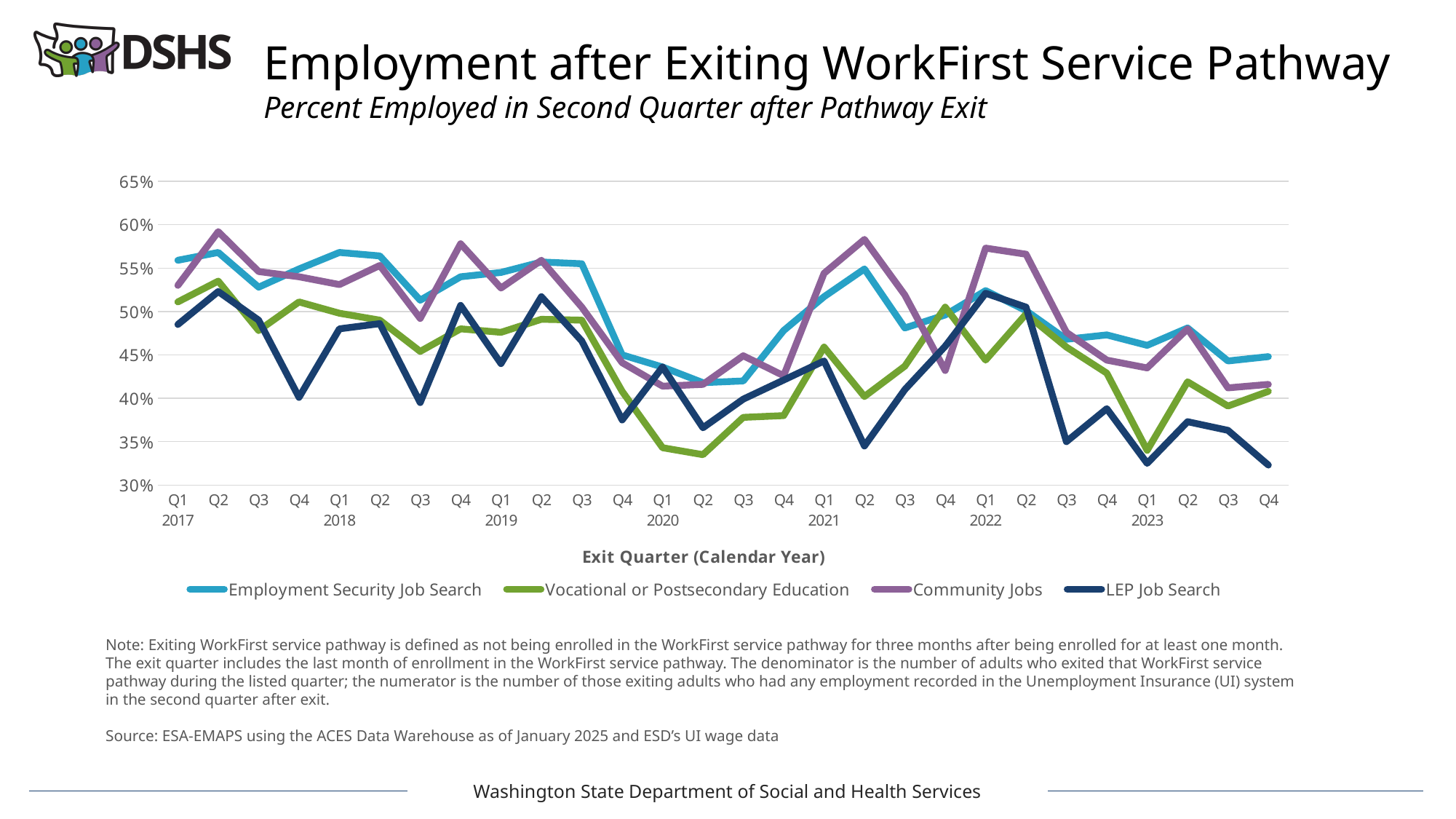
In Q1 2022, which is larger: Community Jobs or LEP Job Search? Community Jobs Which series has the lowest value in Q4 2023? LEP Job Search What kind of chart is shown on the slide? Line chart Is the value for LEP Job Search in Q4 2023 greater or less than 35%? less How many exit quarters are plotted along the x axis? 28 How many series does the legend list? 4 Is the value for Vocational or Postsecondary Education in Q2 2020 greater or less than 35%? less Which series has the highest value in Q2 2017? Community Jobs Is the value for Community Jobs in Q2 2017 greater or less than 55%? greater Does the LEP Job Search line rise or fall overall from Q1 2022 to Q4 2023? Fall What is the title of the x axis? Exit Quarter (Calendar Year)